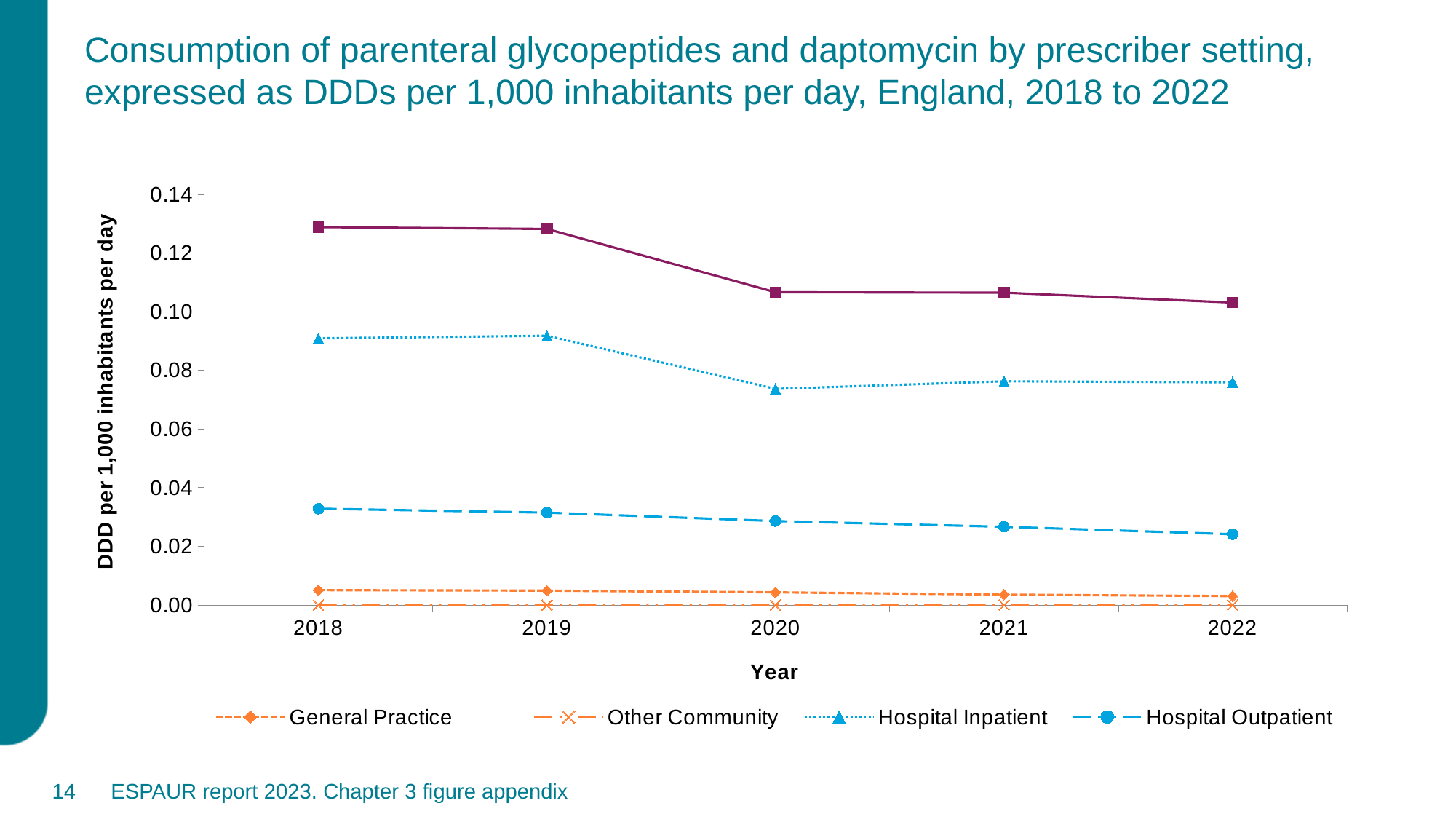
Is the value for Hospital Outpatient in 2018 greater or less than 0.04? less What is the title of the x axis? Year How many years are shown on the x axis? 5 Is the value for Hospital Inpatient in 2020 greater or less than 0.08? less Is the value for General Practice in 2018 greater or less than 0.02? less How many series does the legend list? 4 What kind of chart is shown on the slide? line chart Does the Hospital Outpatient line rise or fall from 2018 to 2022? fall Which is larger in 2019, Hospital Inpatient or Hospital Outpatient? Hospital Inpatient Of the series listed in the legend, which has the lowest value in 2022? Other Community